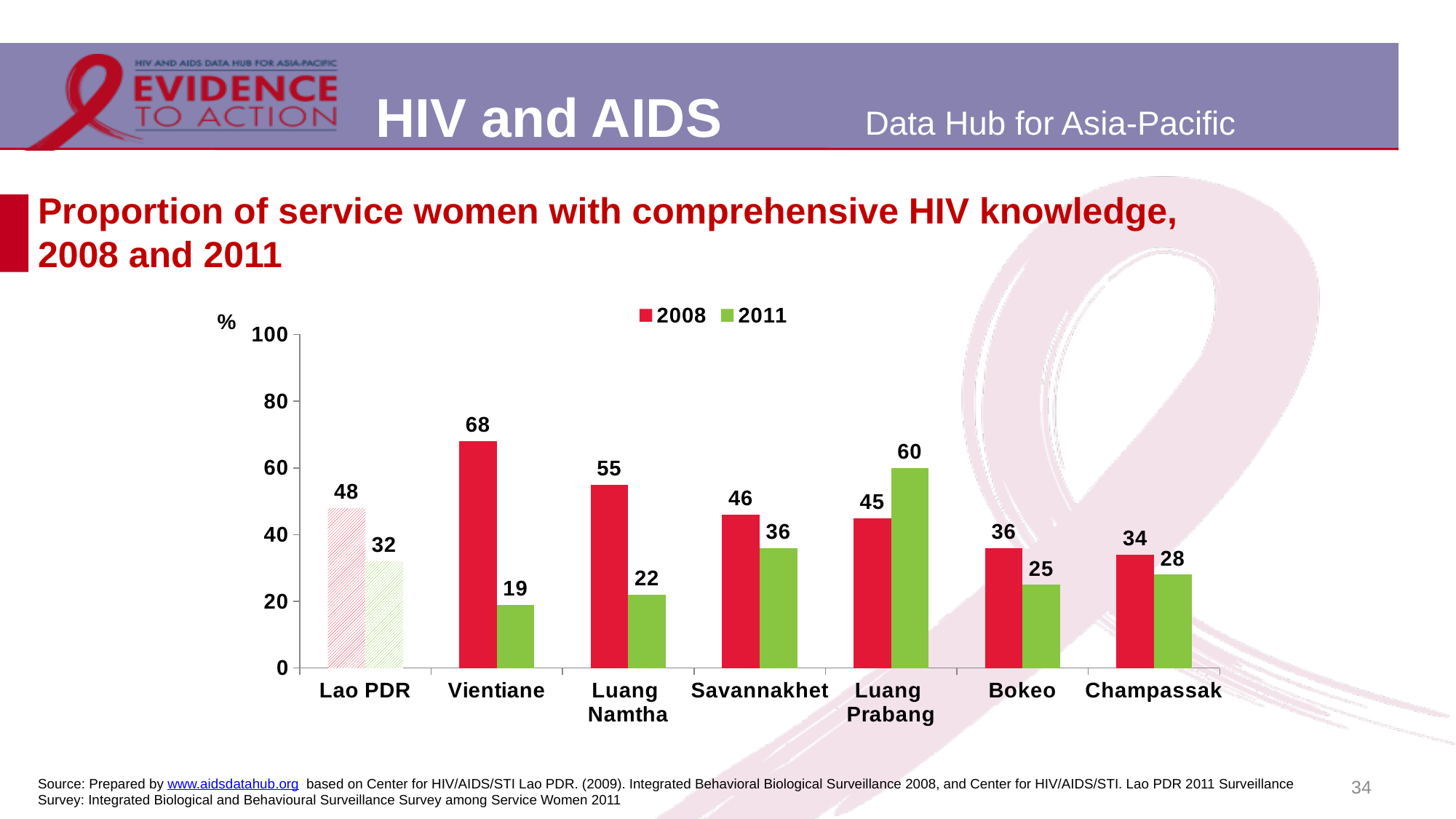
Which category has the lowest 2011 value? Vientiane What was the 2011 value for Luang Prabang? 60 What is the difference between the 2008 and 2011 values for Vientiane? 49 Which series is shown in green in the legend? 2011 What kind of chart is shown on the slide? Bar chart What was the proportion of service women with comprehensive HIV knowledge in Vientiane in 2008? 68 Which category has the highest 2008 value? Vientiane What was the 2011 value for Lao PDR? 32 How many categories are shown on the x axis? 7 How many series does the legend list? 2 Is the 2008 value for Luang Namtha greater or less than 40? greater Which is larger for Luang Prabang, the 2008 value or the 2011 value? 2011